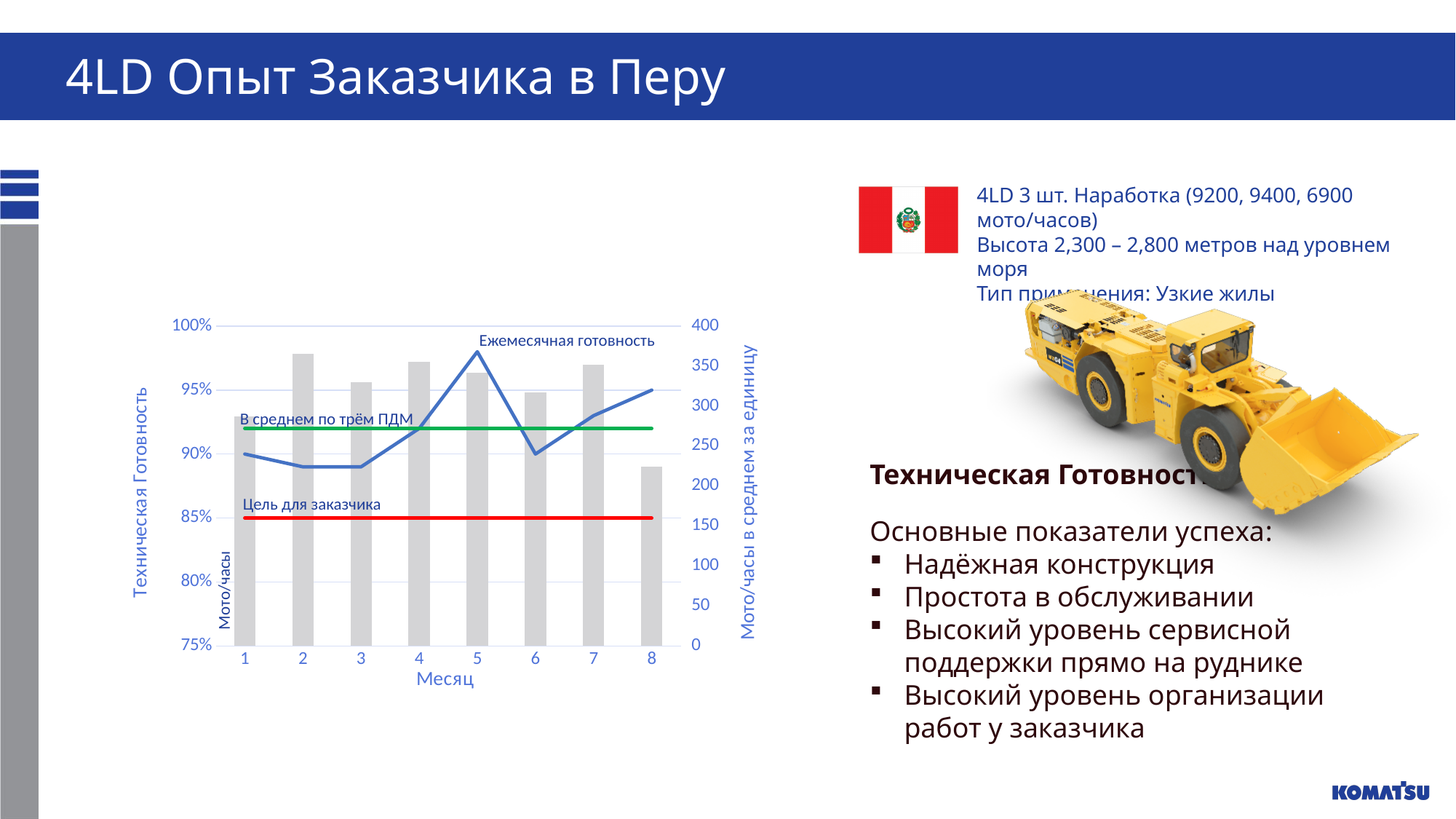
Is the Ежемесячная готовность value for month 4 greater or less than 90%? greater Is the Ежемесячная готовность value for month 5 greater or less than 95%? greater In which month is the Мото/часы bar the highest? 2 How many months are shown on the x axis of the chart? 8 Does the Ежемесячная готовность line rise or fall from month 5 to month 6? fall In which month is the Мото/часы bar the lowest? 8 Which month has the larger Мото/часы bar, month 2 or month 8? 2 Is the Мото/часы value for month 8 greater or less than 250? less What kind of chart is shown on the slide? A combined bar and line chart At what level is the Цель для заказчика line drawn on the left axis? 85% In which month does the Ежемесячная готовность line reach its highest point? 5